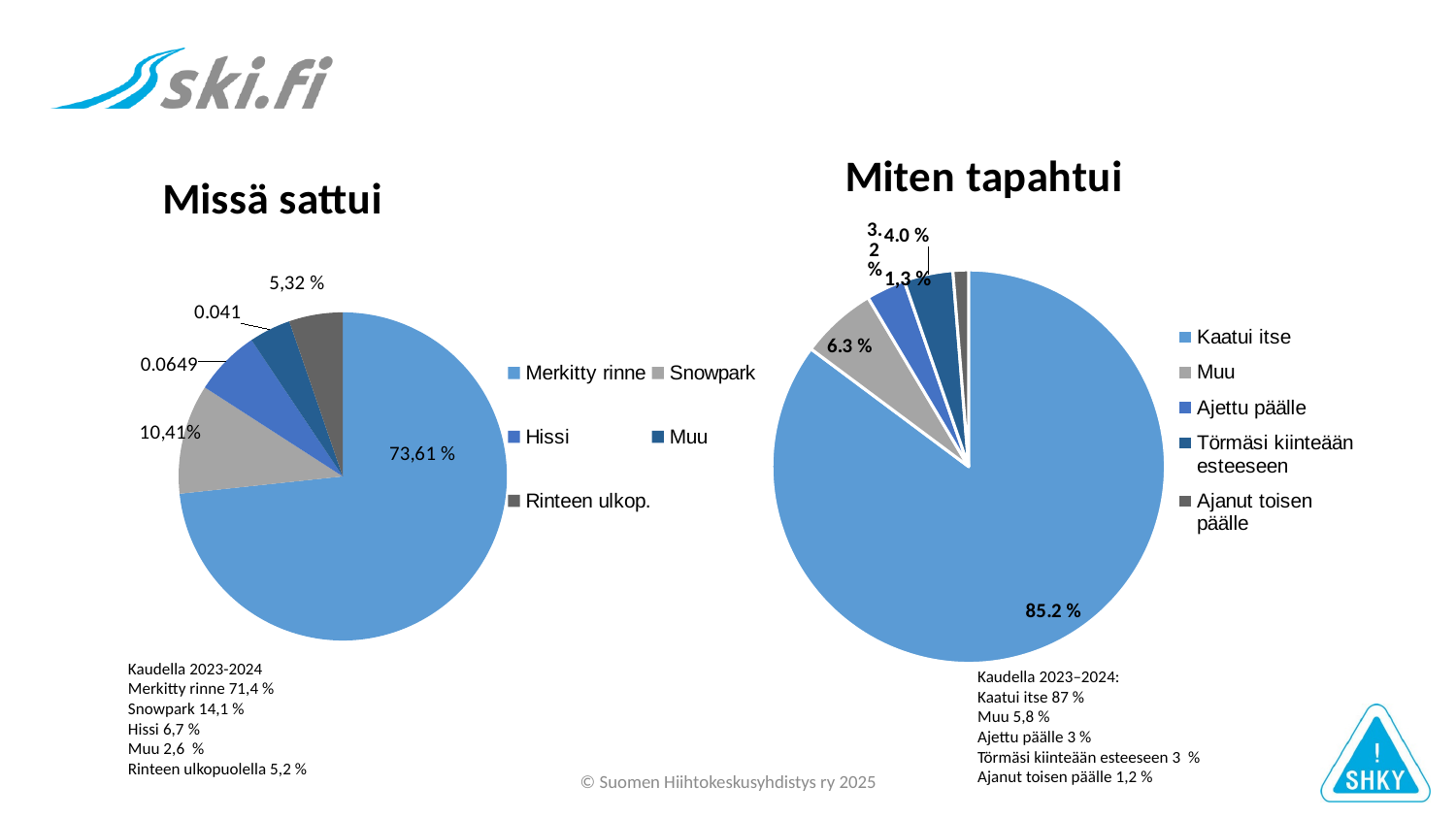
In the 'Missä sattui' chart, which category has the largest slice? Merkitty rinne What type of chart is 'Missä sattui'? Pie chart In the 'Miten tapahtui' chart, which category has the largest slice? Kaatui itse In the 'Missä sattui' chart, how many categories does the legend list? 5 In the 'Missä sattui' chart, what share is shown for Snowpark? 10,41% What is the title of the chart on the right side of the slide? Miten tapahtui In the 'Missä sattui' chart, what value is shown for Rinteen ulkop.? 5,32 % In the 'Miten tapahtui' chart, how many categories does the legend list? 5 In the 'Miten tapahtui' chart, what share is shown for Kaatui itse? 85.2 % In the 'Miten tapahtui' chart, what share is shown for Muu? 6.3 % In the 'Missä sattui' chart, what share is shown for Merkitty rinne? 73,61 % In the 'Miten tapahtui' chart, which is larger: Kaatui itse or Muu? Kaatui itse